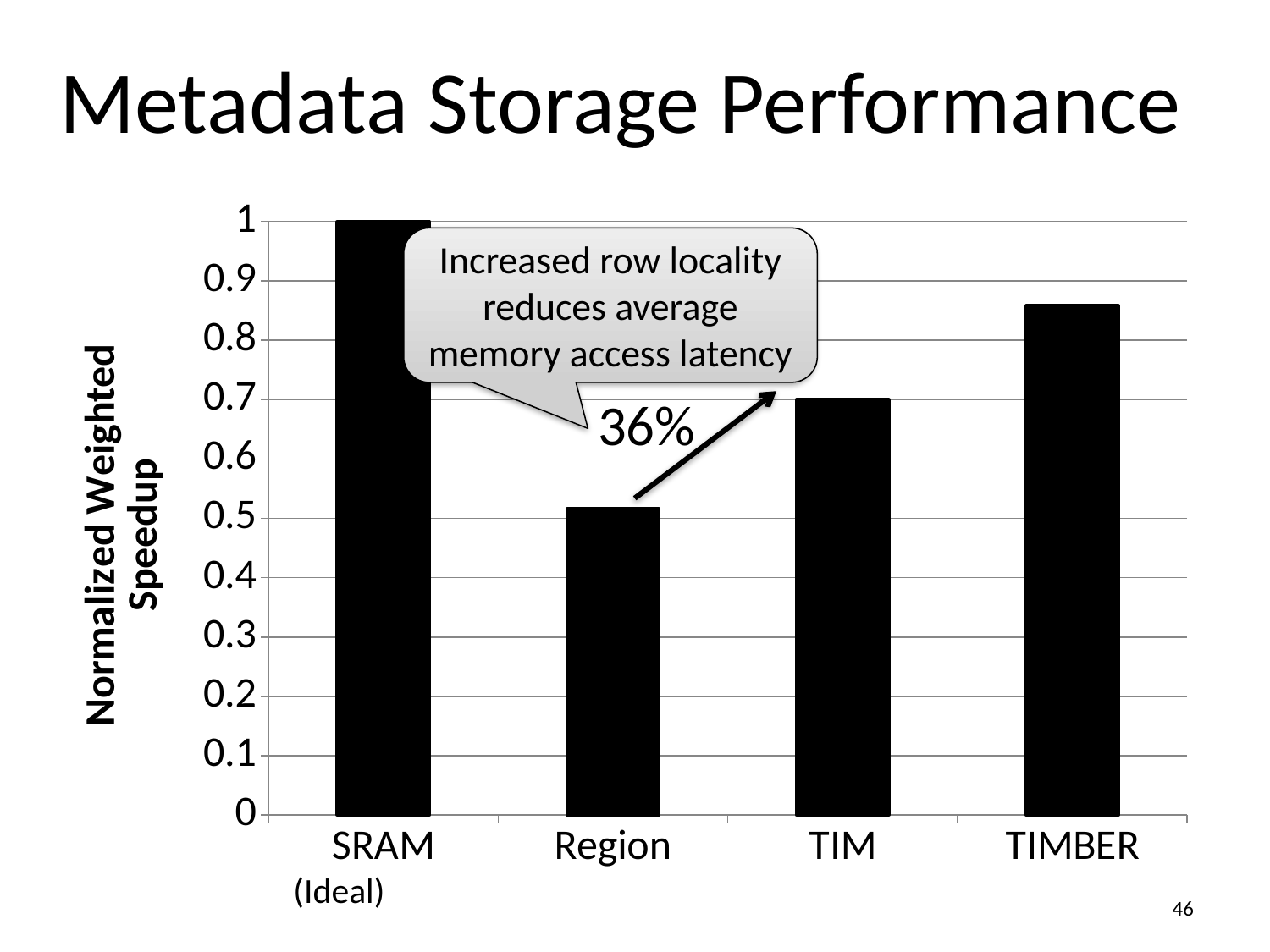
What is the normalized weighted speedup for SRAM (Ideal)? 1 Is the value for TIMBER greater or less than 0.8? greater Is the value for Region greater or less than 0.5? greater What is the label of the y axis? Normalized Weighted Speedup Is the value for TIMBER greater or less than 0.9? less What kind of chart is shown on the slide? bar chart Which has a larger normalized weighted speedup, TIM or TIMBER? TIMBER Which category has the lowest normalized weighted speedup? Region How many categories are plotted on the x axis? 4 Which category has the highest normalized weighted speedup? SRAM (Ideal)